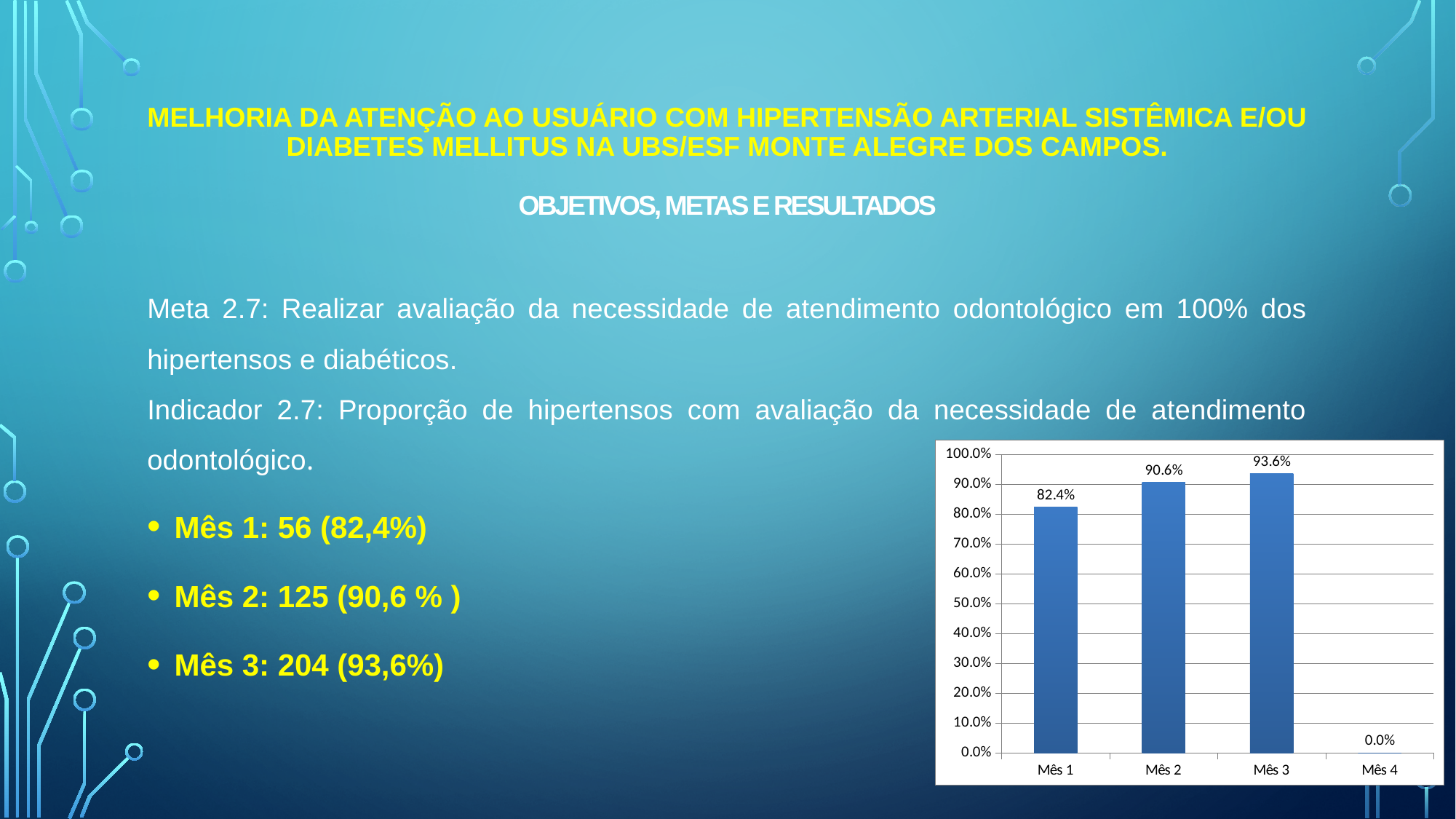
Is the value for Mês 2 greater or less than 90.0%? greater How many categories are shown on the x axis of the chart? 4 What is the value for Mês 4 in the chart? 0.0% What is the value for Mês 1 in the chart? 82.4% What is the difference between the values for Mês 3 and Mês 1? 11.2% Do the values rise or fall from Mês 1 to Mês 3? rise What is the value for Mês 3 in the chart? 93.6% What is the value for Mês 2 in the chart? 90.6% Which month has the highest value in the chart? Mês 3 Which month has the lowest value in the chart? Mês 4 What kind of chart is shown on the slide? bar chart Which is larger, the value for Mês 2 or the value for Mês 1? Mês 2